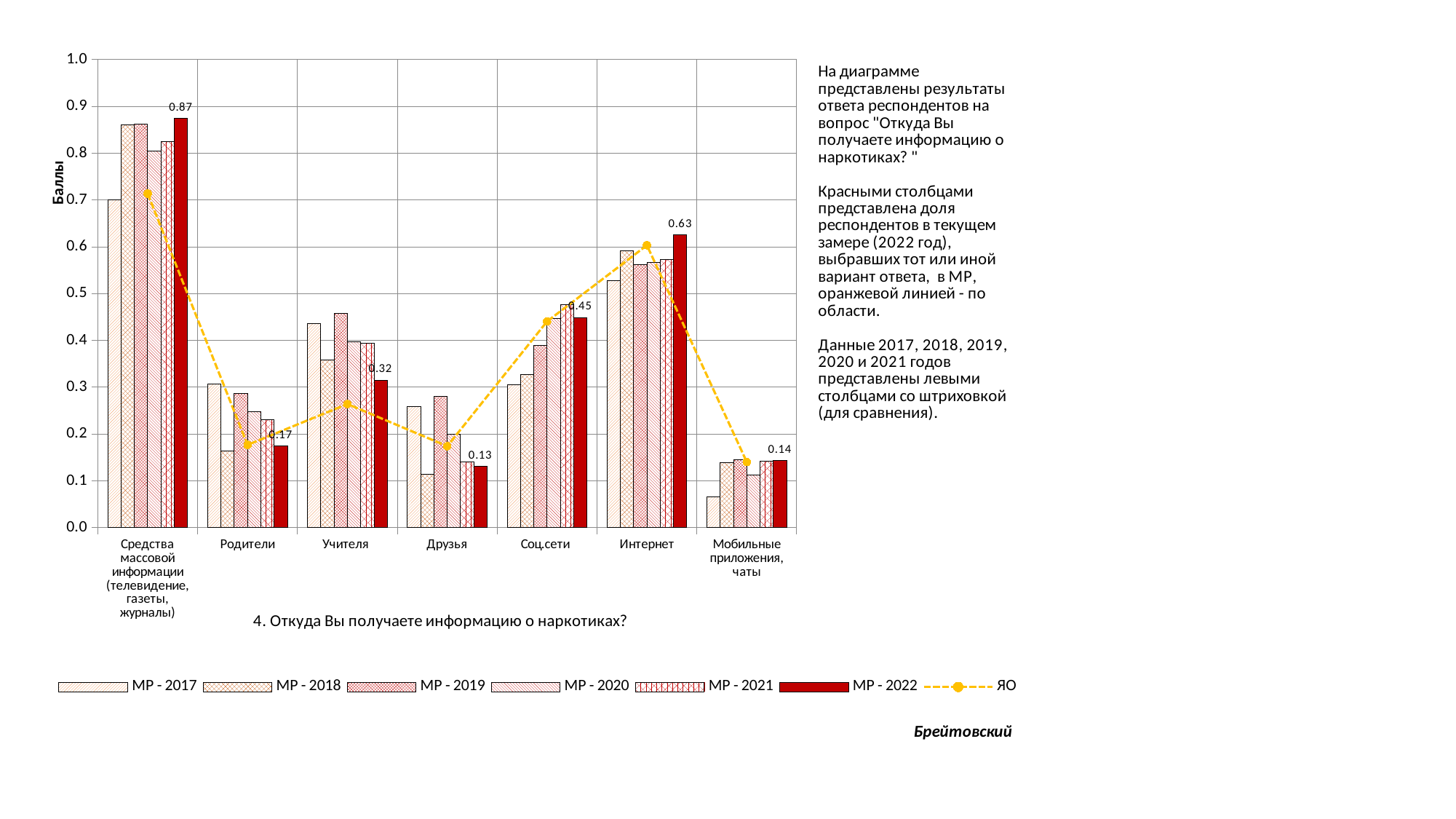
What is the value of the MP - 2022 series for "Друзья"? 0.13 What is the difference between the MP - 2022 values for "Средства массовой информации" and "Интернет"? 0.24 How many categories are shown on the x axis? 7 Which category has the highest MP - 2022 value? Средства массовой информации (телевидение, газеты, журналы) What is the label of the vertical axis? Баллы Is the ЯО line value for "Мобильные приложения, чаты" greater or less than 0.2? less What is the value of the MP - 2022 series for "Соц.сети"? 0.45 What is the value of the MP - 2022 series for the category "Средства массовой информации (телевидение, газеты, журналы)"? 0.87 What is the value of the MP - 2022 series for "Интернет"? 0.63 Which has the larger MP - 2022 value: "Интернет" or "Соц.сети"? Интернет How many series does the legend list? 7 Is the ЯО line value for "Средства массовой информации" greater or less than 0.6? greater